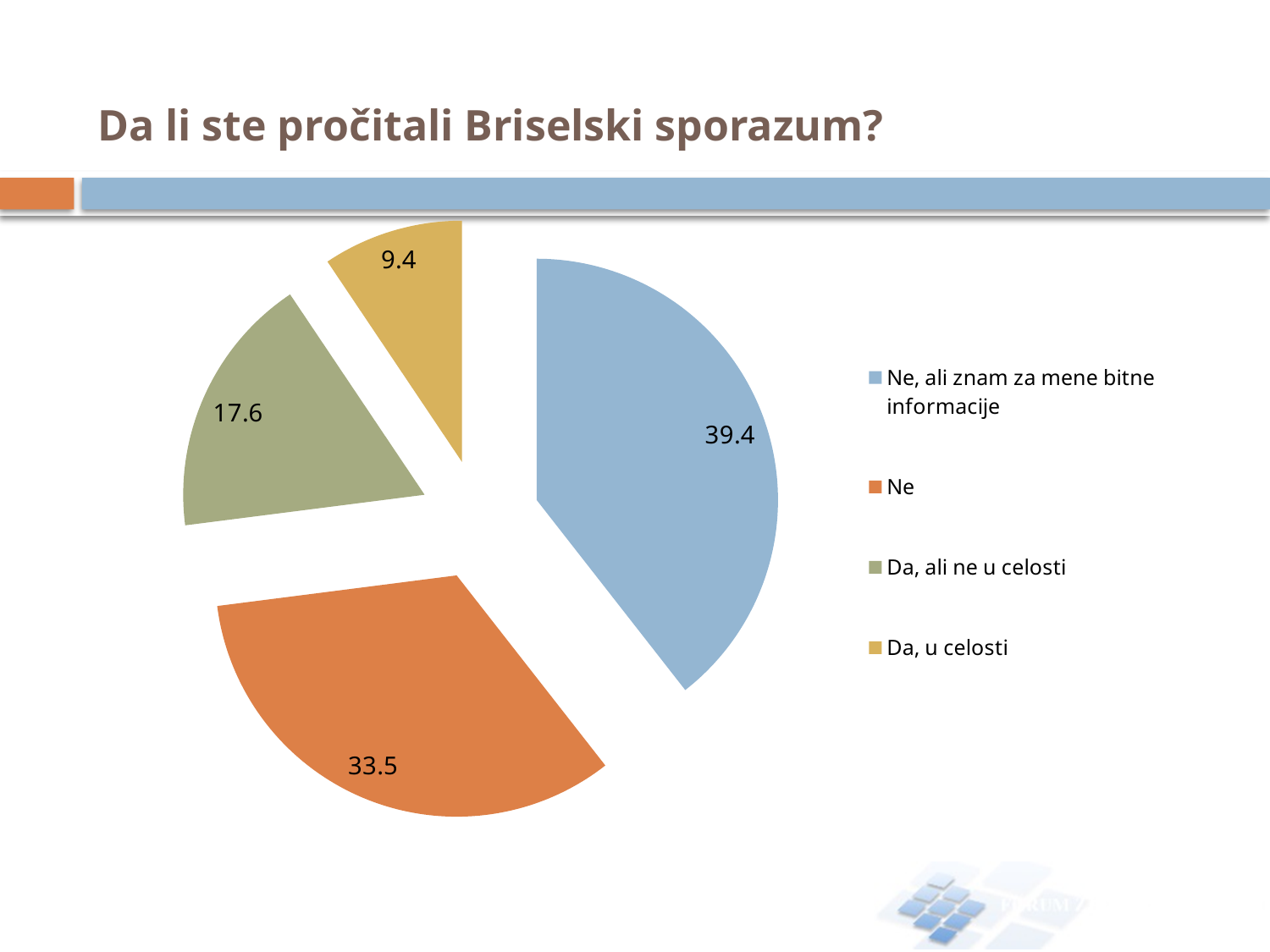
Which category has the smallest slice? Da, u celosti What is the value for "Da, u celosti"? 9.4 What is the value for "Da, ali ne u celosti"? 17.6 How many slices does the pie chart have? 4 Which is larger, the value for "Ne" or the value for "Da, ali ne u celosti"? Ne What type of chart is shown on the slide? pie chart What is the value for "Ne, ali znam za mene bitne informacije"? 39.4 What is the difference between the values for "Da, ali ne u celosti" and "Da, u celosti"? 8.2 What is the title of the slide containing the chart? Da li ste pročitali Briselski sporazum? What is the value for "Ne"? 33.5 Which category has the largest slice? Ne, ali znam za mene bitne informacije What is the difference between the values for "Ne, ali znam za mene bitne informacije" and "Ne"? 5.9